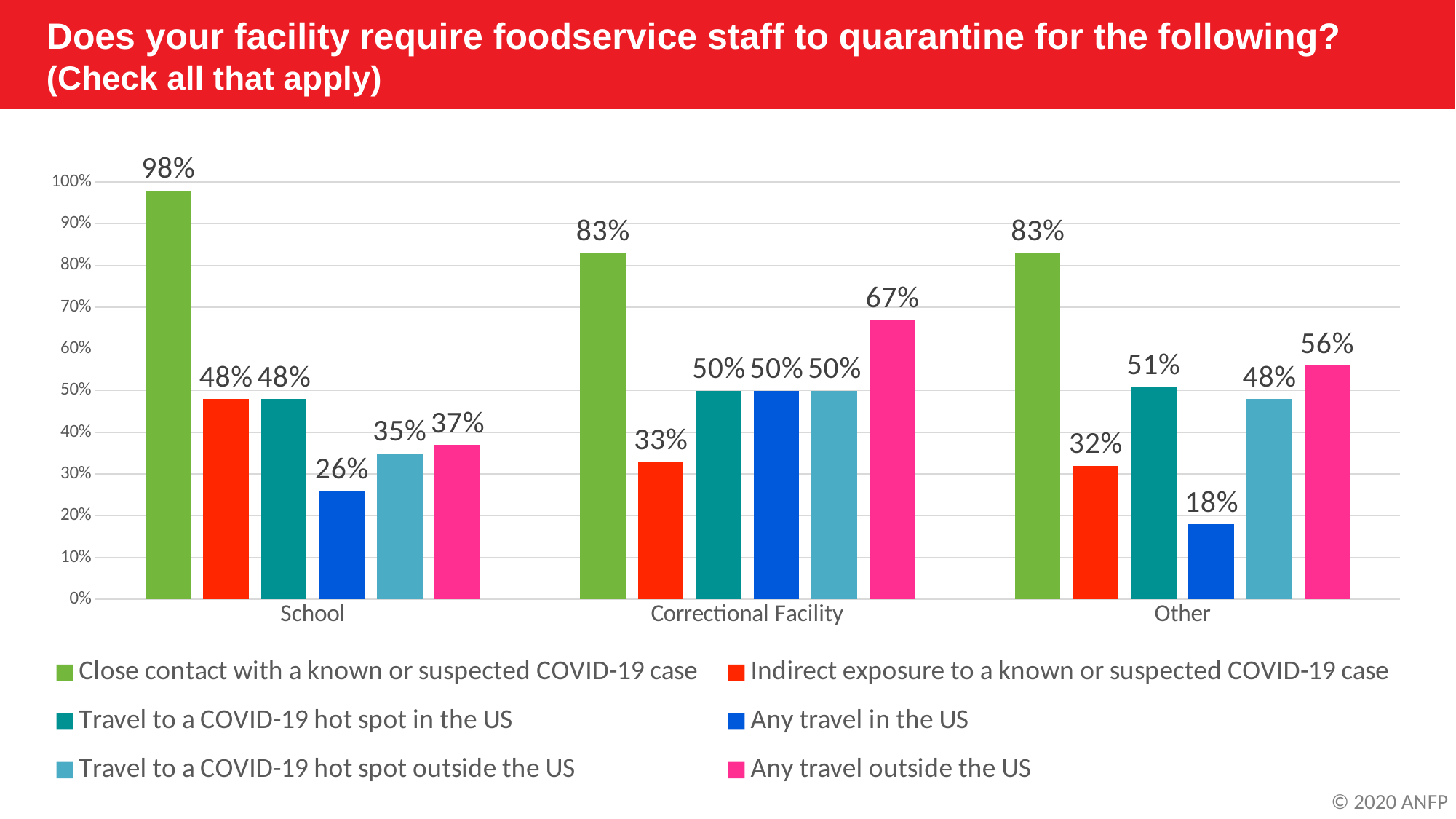
Is the value for 'Indirect exposure to a known or suspected COVID-19 case' higher in School or in Other? School Which colour represents 'Any travel outside the US' in the legend? Pink What is the value for 'Any travel in the US' in the Other category? 18% What is the value for 'Any travel outside the US' in the Correctional Facility category? 67% Which series has the lowest value in the School category? Any travel in the US What percentage of schools require foodservice staff to quarantine after close contact with a known or suspected COVID-19 case? 98% What is the difference between 'Any travel outside the US' and 'Any travel in the US' in the Other category? 38% What kind of chart is shown on the slide? Bar chart How many categories are shown on the x axis? 3 How many series does the legend list? 6 Which category has the highest value for 'Close contact with a known or suspected COVID-19 case'? School What is the difference between 'Close contact with a known or suspected COVID-19 case' for School and for Correctional Facility? 15%